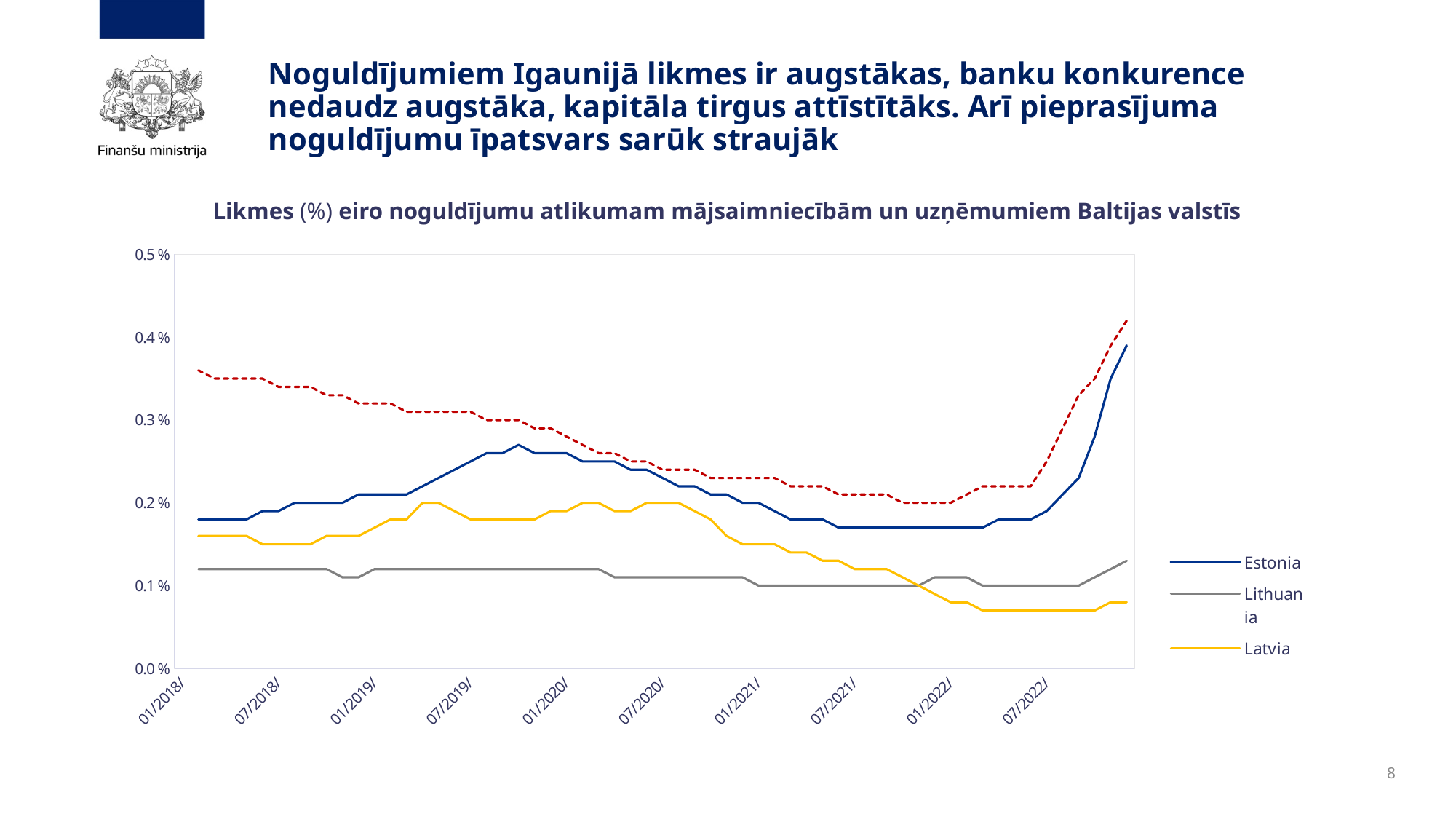
Is the value for Latvia at 07/2022 greater or less than 0.1 %? less Is the value for Estonia at the last point of the chart greater or less than 0.3 %? greater How many series does the chart legend list? 3 Does the Latvia line rise or fall between 07/2020 and 07/2022? fall Is the value for Estonia at 01/2020 greater or less than 0.2 %? greater What kind of chart is shown on the slide? line chart What colour is the Latvia line in the chart? yellow Does the Estonia line rise or fall from 07/2022 to the end of the chart? rise Which three countries are listed in the chart legend? Estonia, Lithuania, Latvia Of the three series in the legend, which has the lowest value at the last point of the chart? Latvia At 01/2018, which is higher: the value for Estonia or the value for Lithuania? Estonia